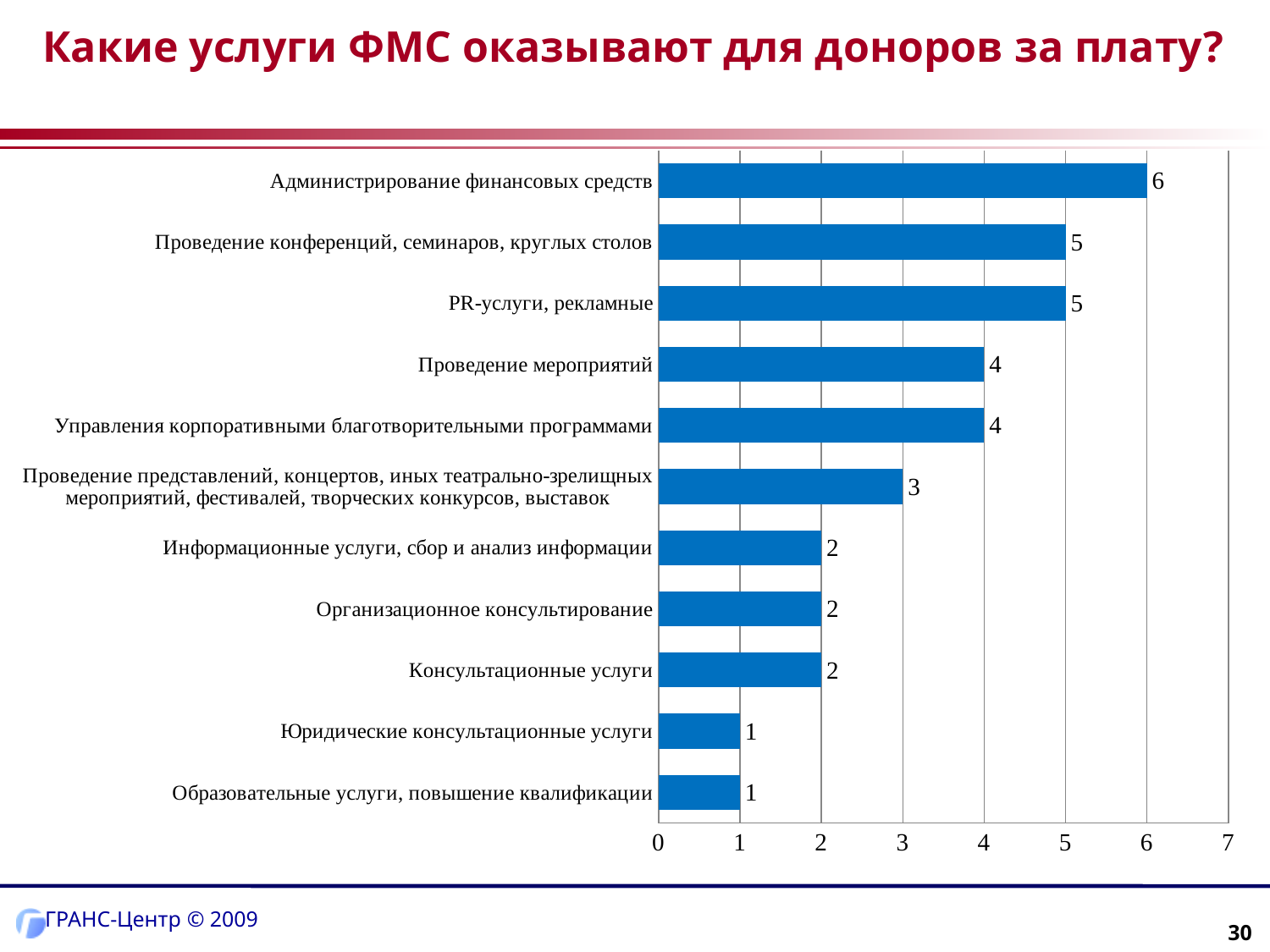
How many categories are shown in the chart? 11 What is the difference between the values for Проведение конференций, семинаров, круглых столов and Проведение представлений, концертов, иных театрально-зрелищных мероприятий, фестивалей, творческих конкурсов, выставок? 2 What is the value for Администрирование финансовых средств? 6 What is the value for Проведение мероприятий? 4 Which is larger: the value for PR-услуги, рекламные or the value for Консультационные услуги? PR-услуги, рекламные What kind of chart is shown on the slide? bar chart What is the title of the slide? Какие услуги ФМС оказывают для доноров за плату? What is the value for Юридические консультационные услуги? 1 What is the value for Информационные услуги, сбор и анализ информации? 2 What is the difference between the values for Администрирование финансовых средств and Образовательные услуги, повышение квалификации? 5 Is the value for Проведение конференций, семинаров, круглых столов greater or less than 3? greater Which category has the highest value? Администрирование финансовых средств